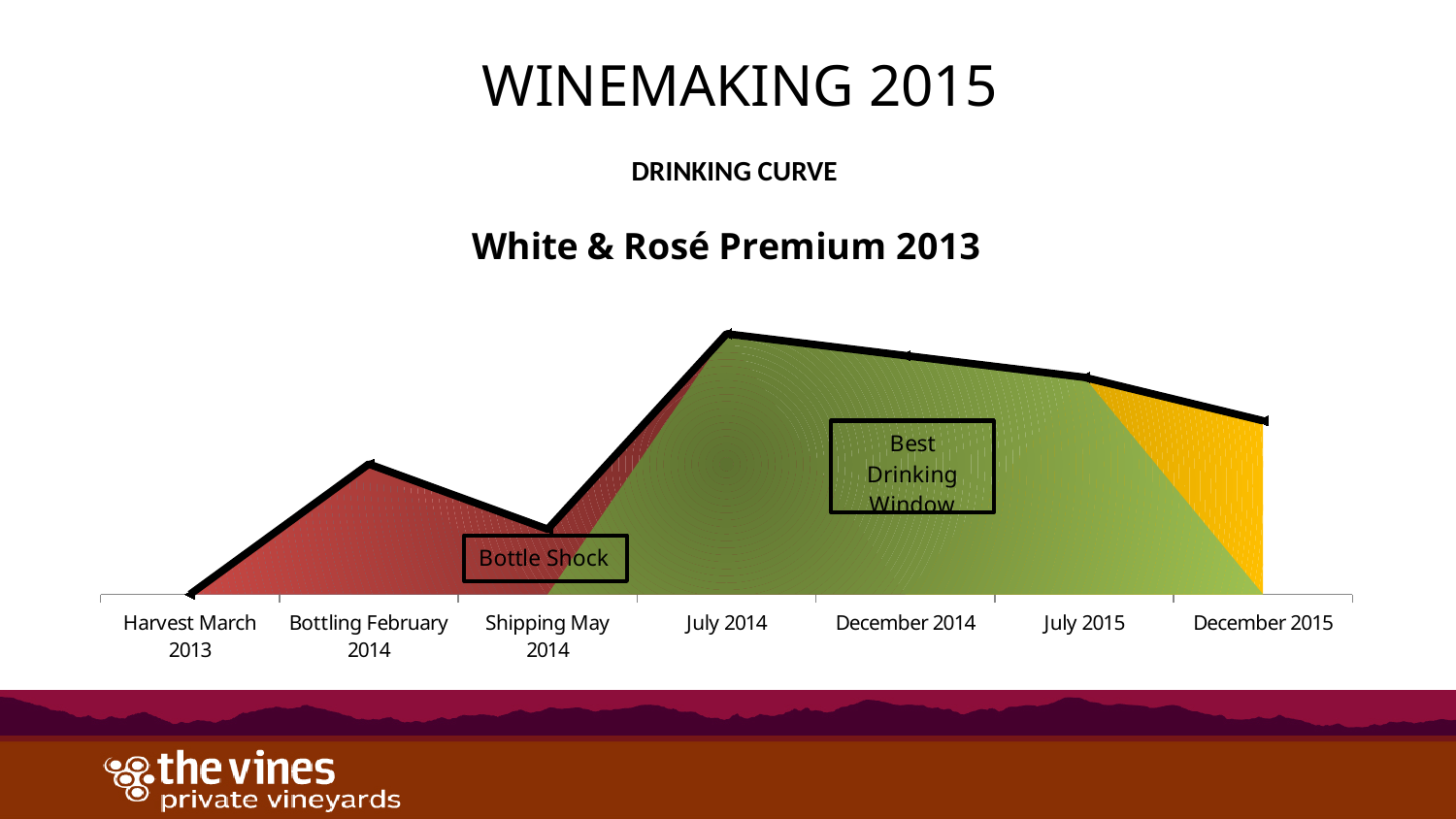
Which is higher, the value at July 2014 or at December 2015? July 2014 Do the values rise or fall from Shipping May 2014 to July 2014? rise What label is shown in the box near the dip at Shipping May 2014? Bottle Shock Which point on the x axis has the lowest value? Harvest March 2013 What is the title of the chart? White & Rosé Premium 2013 Do the values rise or fall from July 2014 to December 2015? fall Which is higher, the value at December 2014 or at Shipping May 2014? December 2014 What kind of chart is shown on the slide? area chart Do the values rise or fall from Harvest March 2013 to Bottling February 2014? rise How many points are plotted along the x axis of the chart? 7 Which point on the x axis has the highest value? July 2014 Which is higher, the value at Bottling February 2014 or at Shipping May 2014? Bottling February 2014